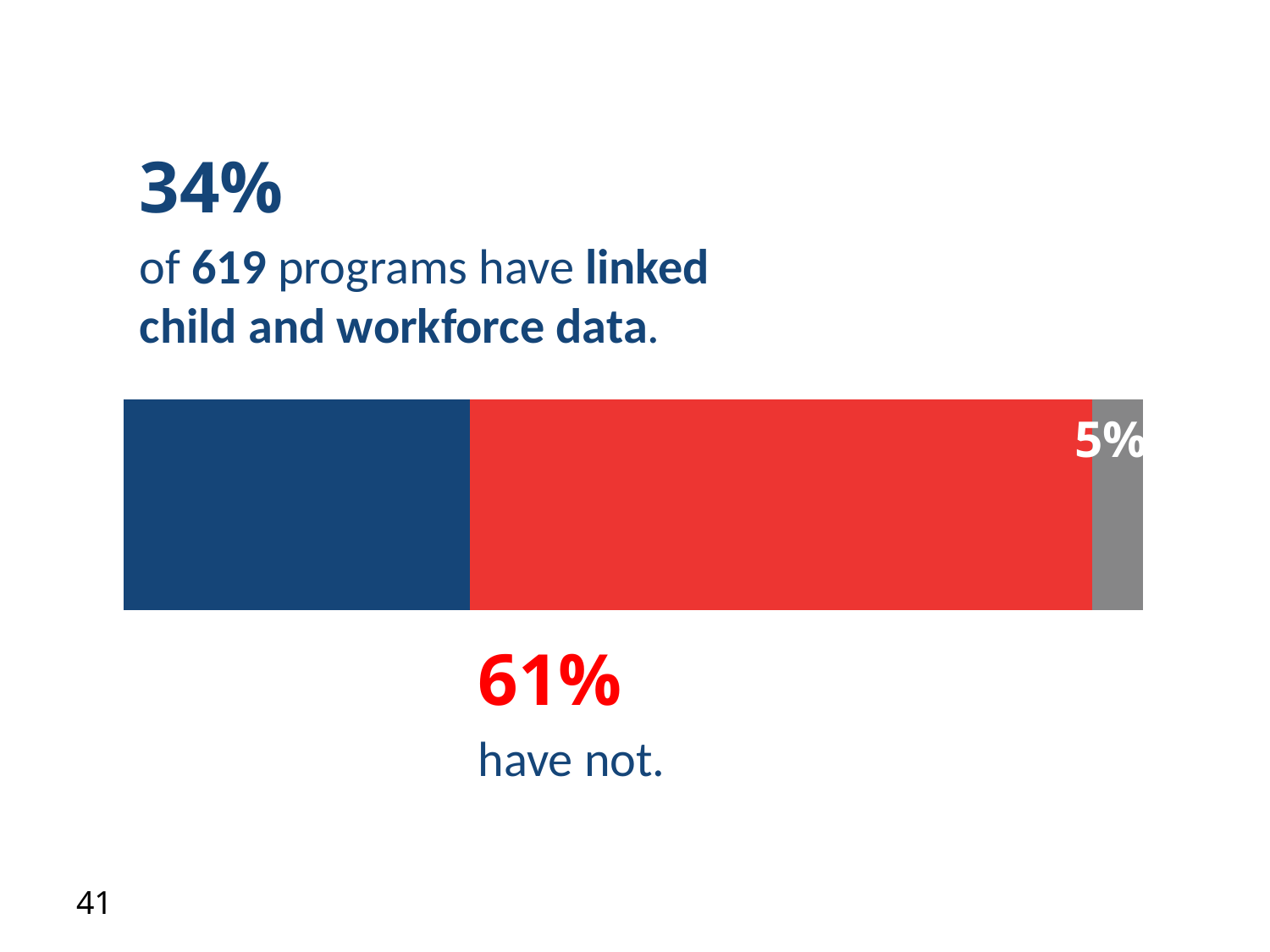
What kind of chart is shown on the slide? stacked bar chart What percentage of programs have linked child and workforce data? 34% How many programs are represented in the bar? 619 Which segment of the bar is the largest? 61% (have not) Which segment of the bar is the smallest? 5% (grey) What is the difference between the share of programs that have not linked data and the share that have? 27% What value is printed on the grey segment of the bar? 5% What percentage of programs have not linked child and workforce data? 61% How many segments does the bar have? 3 Which is larger: the share of programs that have linked child and workforce data or the share that have not? have not (61%) What is the total of the three segments in the bar? 100% What colour is the segment representing programs that have linked child and workforce data? blue